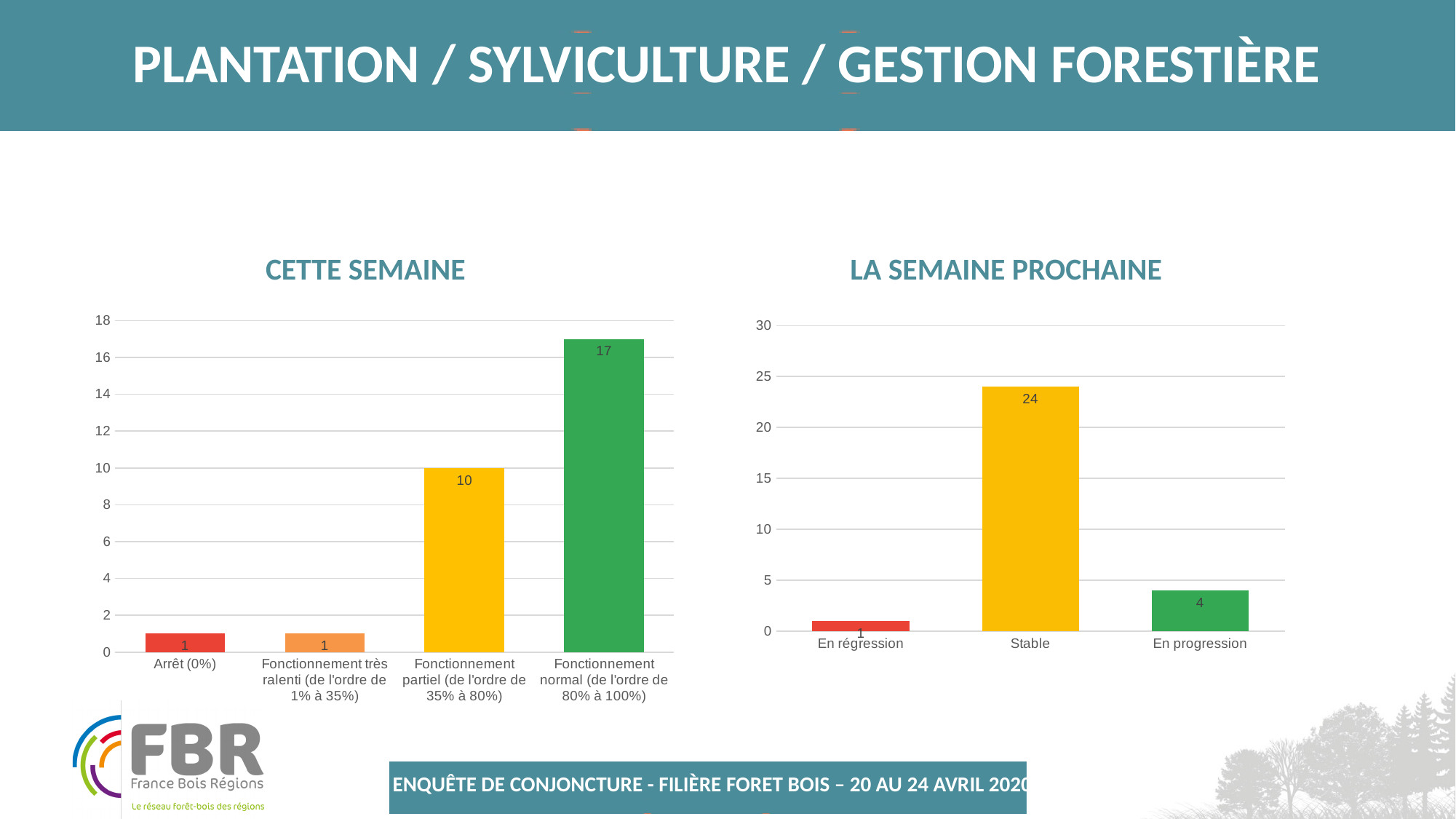
In the 'LA SEMAINE PROCHAINE' chart, which category has the lowest value? En régression In the 'CETTE SEMAINE' chart, what is the value for 'Fonctionnement partiel (de l'ordre de 35% à 80%)'? 10 In the 'CETTE SEMAINE' chart, what is the difference between 'Fonctionnement normal' and 'Fonctionnement partiel'? 7 In the 'LA SEMAINE PROCHAINE' chart, which is larger: 'En progression' or 'En régression'? En progression In the 'CETTE SEMAINE' chart, what is the value for 'Fonctionnement normal (de l'ordre de 80% à 100%)'? 17 In the 'CETTE SEMAINE' chart, which category has the highest value? Fonctionnement normal (de l'ordre de 80% à 100%) In the 'LA SEMAINE PROCHAINE' chart, what is the difference between 'Stable' and 'En progression'? 20 In the 'LA SEMAINE PROCHAINE' chart, what is the value for 'En progression'? 4 In the 'CETTE SEMAINE' chart, how many categories are shown? 4 In the 'CETTE SEMAINE' chart, what is the value for 'Arrêt (0%)'? 1 What kind of chart is the 'LA SEMAINE PROCHAINE' chart? Bar chart In the 'LA SEMAINE PROCHAINE' chart, what is the value for 'Stable'? 24